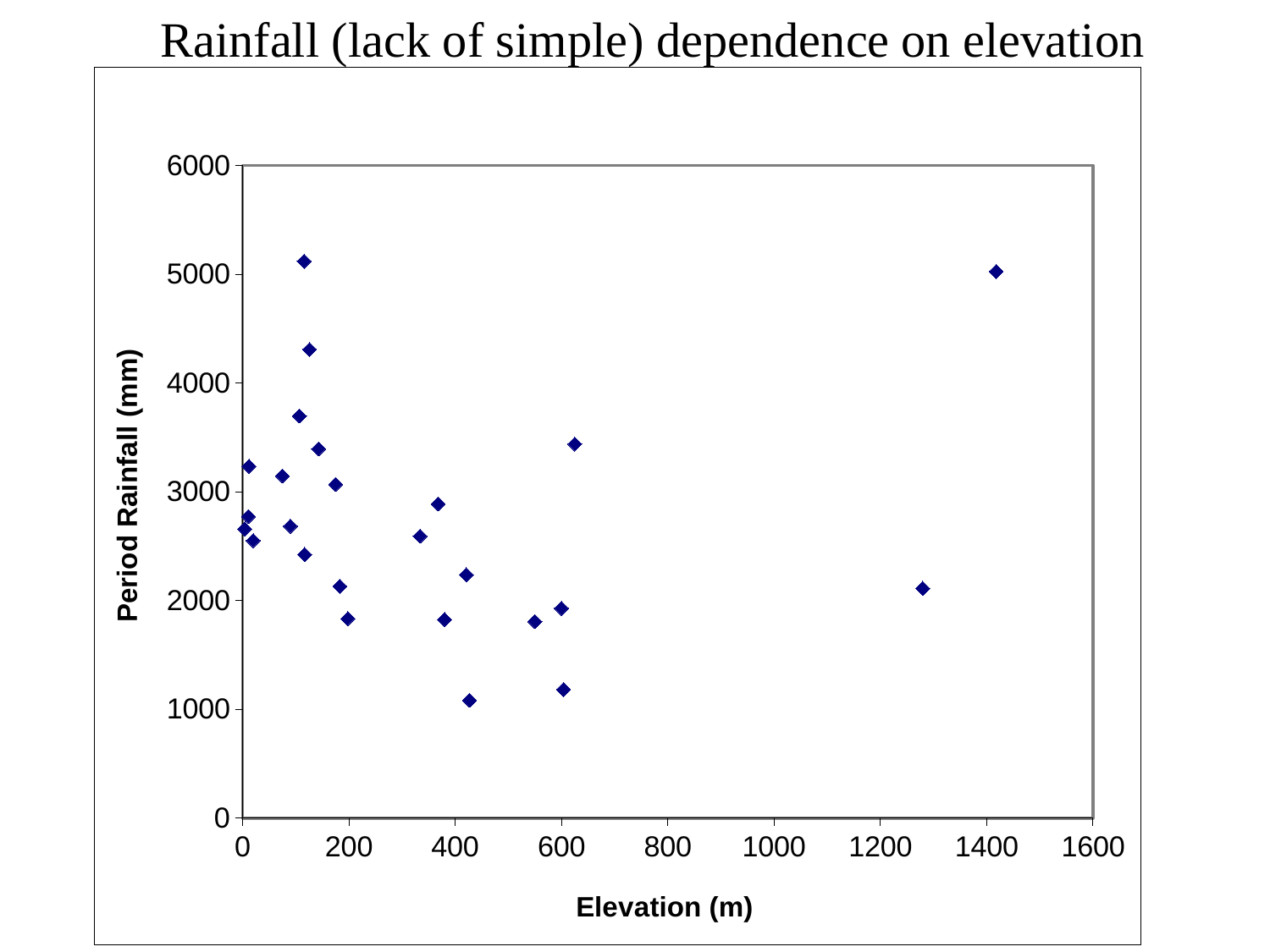
What is the title of the slide's chart? Rainfall (lack of simple) dependence on elevation Does rainfall show a clear steady rise or fall as elevation increases along the x axis? no How many points have a rainfall greater than 4000 mm? 3 What kind of chart is shown on the slide? scatter plot Which has the higher rainfall: the point with the highest elevation or the point with the second-highest elevation? the point with the highest elevation What is the label of the vertical axis? Period Rainfall (mm) Is the rainfall of the point at roughly 1280 m elevation greater or less than 3000? less Is the rainfall of the point with the highest elevation greater or less than 4000? greater Is the rainfall of the point at roughly 620 m elevation greater or less than 3000? greater How many points have an elevation greater than 1000 m? 2